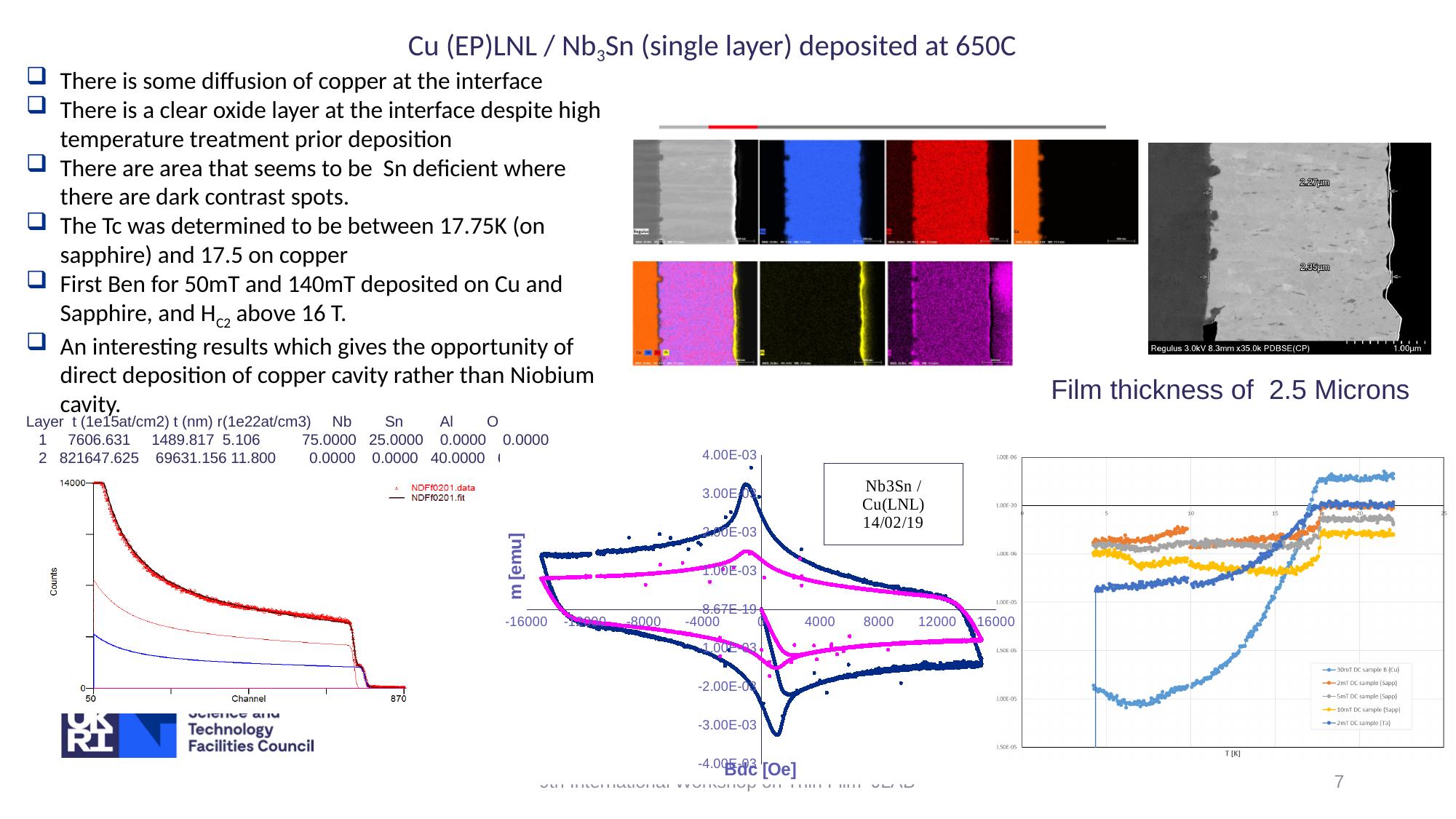
In the bottom-left chart (Counts vs Channel), how many entries does the legend list? 2 In the bottom-right chart (temperature plot), does the light blue '30mT DC sample B (Cu)' series rise or fall as temperature increases from 5 K to 20 K? rise In the middle chart (hysteresis loop), what is the x-axis label? Bdc [Oe] In the bottom-left chart (Counts vs Channel), what is the maximum value shown on the Counts axis? 14000 In the bottom-right chart (temperature plot), what is the x-axis label? T [K] In the bottom-right chart (temperature plot), which legend entry is the first one listed? 30mT DC sample B (Cu) In the bottom-left chart (Counts vs Channel), what is the last tick value on the Channel axis? 870 In the middle chart (hysteresis loop), what is the largest x-axis tick value shown? 16000 In the bottom-left chart (Counts vs Channel), do the counts rise or fall as the channel number increases? fall In the bottom-right chart (temperature plot), how many series does the legend list? 5 In the middle chart (hysteresis loop), what is the highest y-axis tick value shown? 4.00E-03